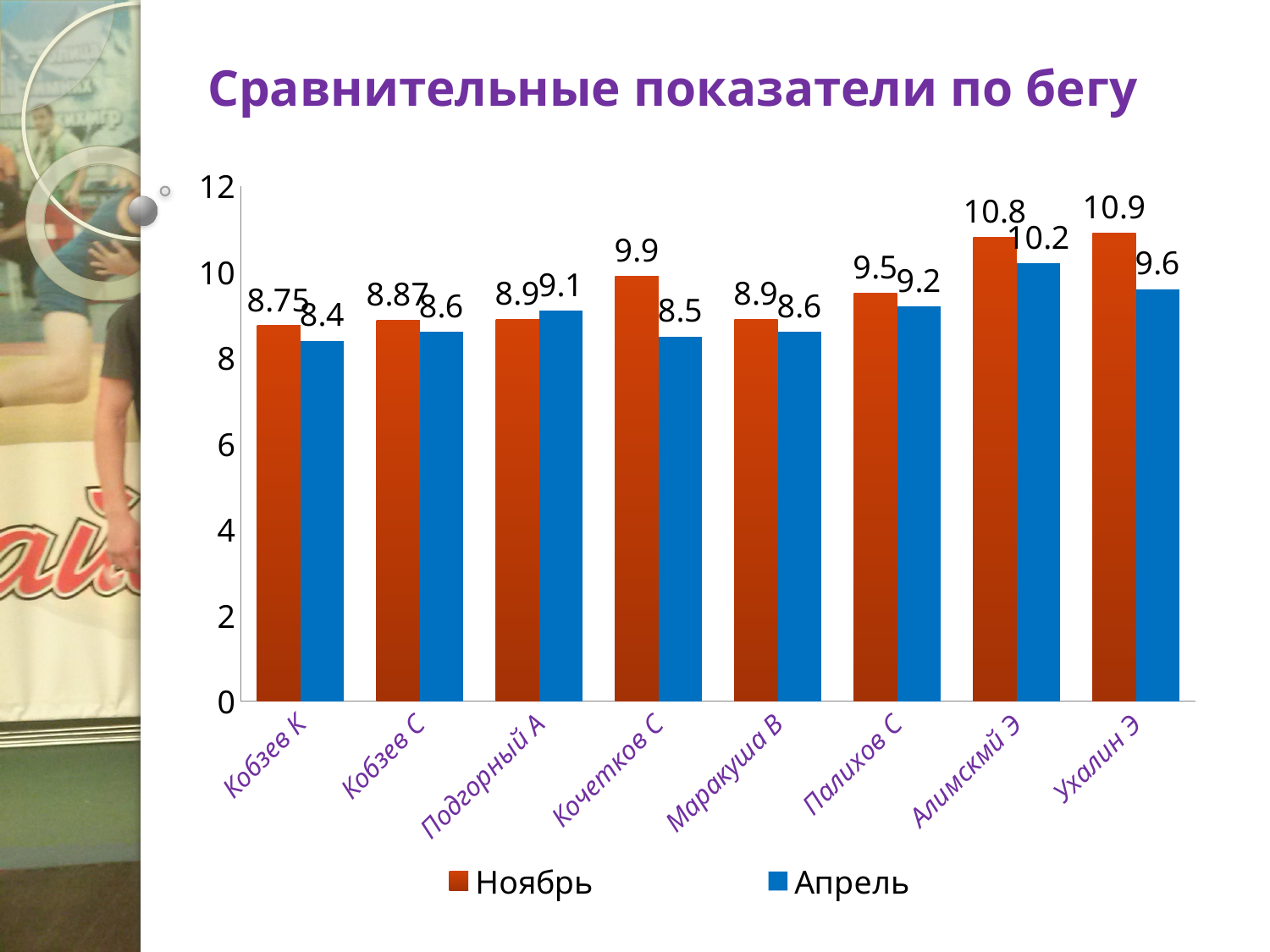
Which is larger for Подгорный А: the Ноябрь value or the Апрель value? Апрель How many categories are shown on the x axis? 8 How many series does the legend list? 2 Which category has the highest Ноябрь value? Ухалин Э What is the Апрель value for Алимский Э? 10.2 Is the Ноябрь value for Ухалин Э greater or less than 10? greater What is the Ноябрь value for Кобзев К? 8.75 What is the difference between the Ноябрь and Апрель values for Кочетков С? 1.4 Which category has the lowest Апрель value? Кобзев К What is the title of the chart? Сравнительные показатели по бегу What is the Ноябрь value for Кочетков С? 9.9 What kind of chart is shown on the slide? bar chart